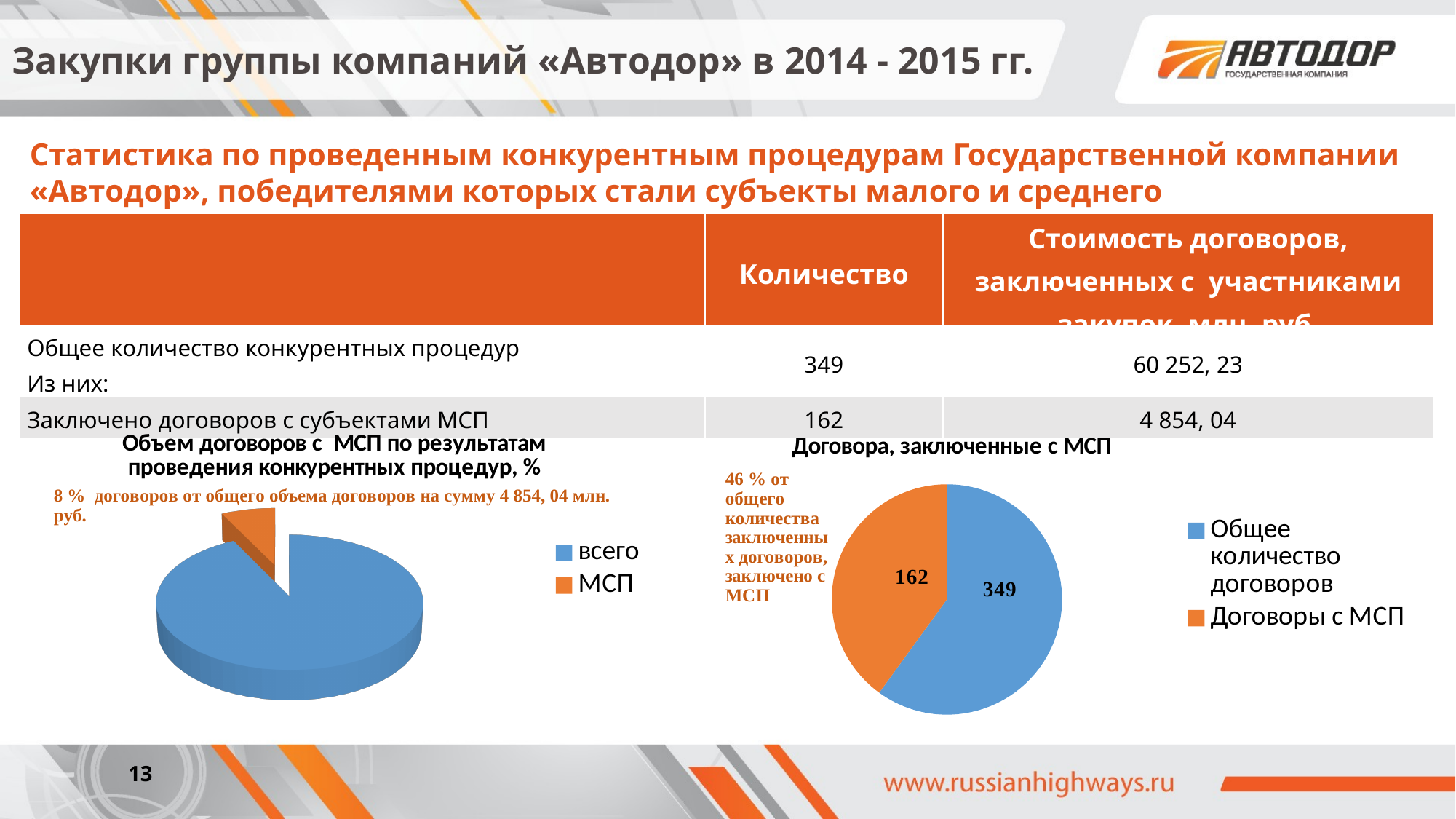
In the chart titled "Договора, заключенные с МСП", what is the difference between the values for "Общее количество договоров" and "Договоры с МСП"? 187 In the chart titled "Объем договоров с МСП по результатам проведения конкурентных процедур, %", what percentage share is stated for the МСП slice? 8 % In the chart titled "Договора, заключенные с МСП", which slice is larger, "Общее количество договоров" or "Договоры с МСП"? Общее количество договоров What kind of chart is the chart titled "Договора, заключенные с МСП"? pie chart In the chart titled "Объем договоров с МСП по результатам проведения конкурентных процедур, %", what colour is the "МСП" slice? orange How many entries does the legend of the chart titled "Договора, заключенные с МСП" list? 2 In the chart titled "Договора, заключенные с МСП", what value is shown for "Договоры с МСП"? 162 How many slices does the chart titled "Объем договоров с МСП по результатам проведения конкурентных процедур, %" have? 2 In the chart titled "Объем договоров с МСП по результатам проведения конкурентных процедур, %", which slice is larger, "всего" or "МСП"? всего In the chart titled "Договора, заключенные с МСП", what colour is the "Общее количество договоров" slice? blue What kind of chart is the chart titled "Объем договоров с МСП по результатам проведения конкурентных процедур, %"? pie chart In the chart titled "Договора, заключенные с МСП", what value is shown for "Общее количество договоров"? 349